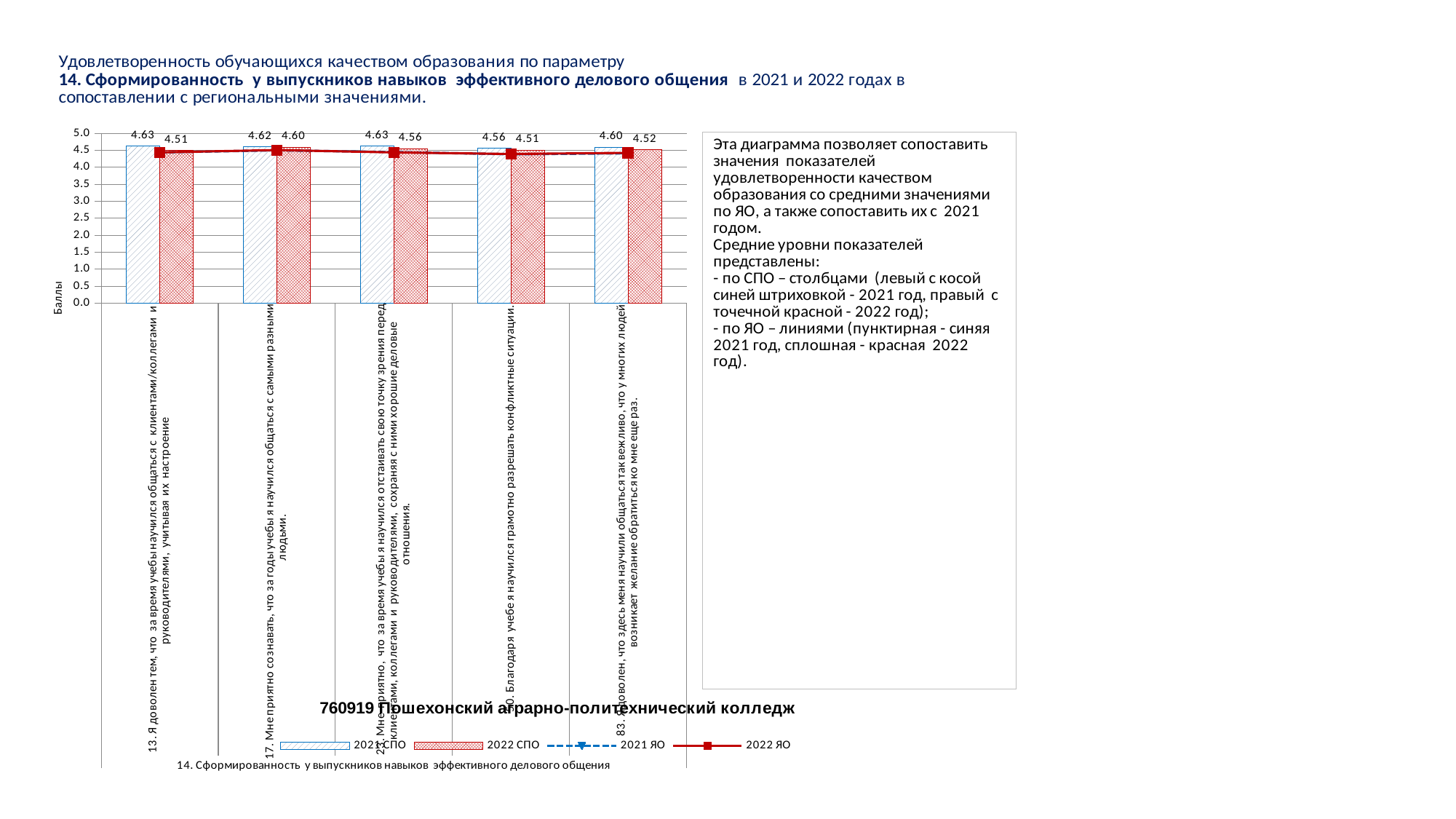
Which item has the highest 2022 СПО value? 17. Мне приятно сознавать, что за годы учебы я научился общаться с самыми разными людьми What is the difference between the 2021 СПО and 2022 СПО values for item 17? 0.02 How many series does the chart legend list? 4 How many categories (survey items) are plotted along the x axis of the chart? 5 What kind of chart is shown on the slide? combination bar and line chart Which item has the lowest 2021 СПО value? 50. Благодаря учебе я научился грамотно разрешать конфликтные ситуации What is the difference between the 2021 СПО and 2022 СПО values for item 13? 0.12 For item 23, which is larger: the 2021 СПО value or the 2022 СПО value? 2021 СПО What is the 2022 СПО value for item 17 ("Мне приятно сознавать, что за годы учебы я научился общаться с самыми разными людьми")? 4.60 What is the title of the vertical axis of the chart? Баллы What is the 2021 СПО value for item 13 ("Я доволен тем, что за время учебы научился общаться с клиентами/коллегами и руководителями...")? 4.63